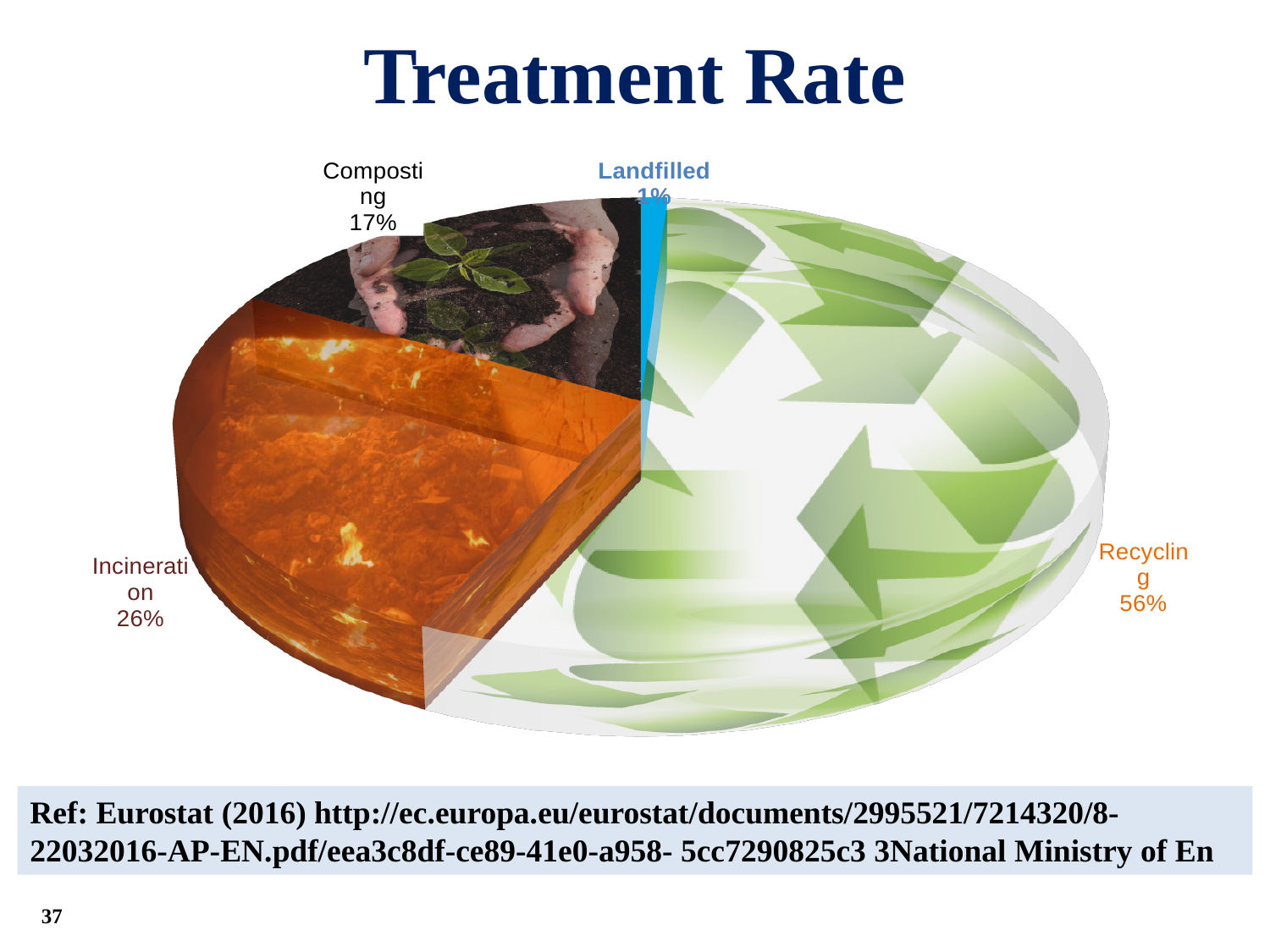
What is the share for Recycling? 56% How many slices does the pie chart have? 4 What is the share for Composting? 17% What is the difference in percentage points between Recycling and Incineration? 30 What is the share for Incineration? 26% What is the share for Landfilled? 1% Which is larger, the share for Incineration or the share for Composting? Incineration What kind of chart is shown on the slide? pie chart What is the difference in percentage points between Composting and Landfilled? 16 Which treatment category has the smallest share of the pie? Landfilled What is the title of the chart? Treatment Rate Which treatment category has the largest share of the pie? Recycling